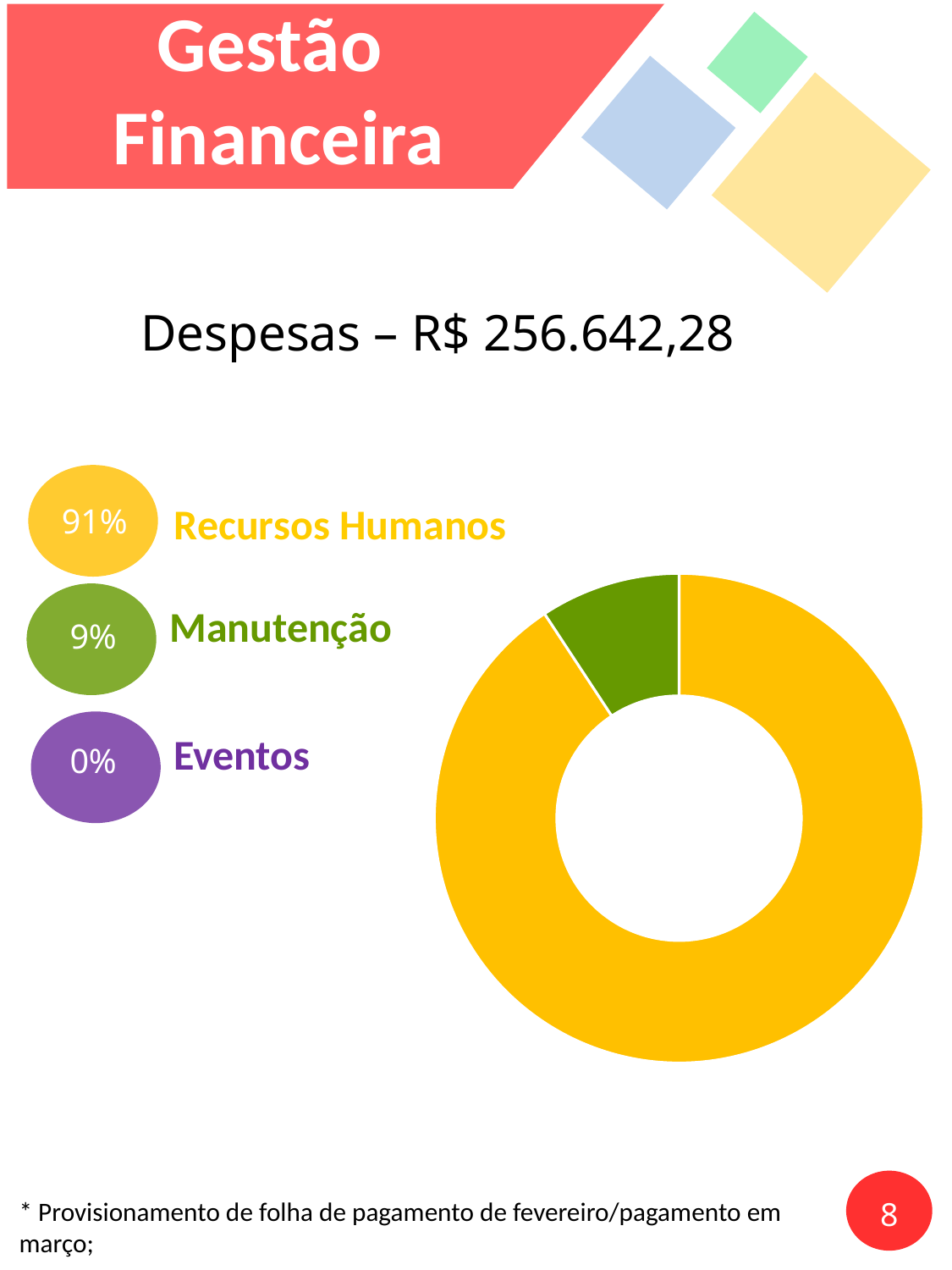
What is the total amount of expenses (Despesas) stated on the slide? R$ 256.642,28 Which is larger, the share for Manutenção or the share for Eventos? Manutenção What is the difference in percentage points between Recursos Humanos and Manutenção? 82 What share of expenses goes to Manutenção? 9% Which category has the largest share of expenses? Recursos Humanos What share of expenses goes to Recursos Humanos? 91% What share of expenses goes to Eventos? 0% Which category has the smallest share of expenses? Eventos How many expense categories are shown in the chart? 3 What kind of chart is shown on the slide? Doughnut chart What colour represents Manutenção in the chart? Green